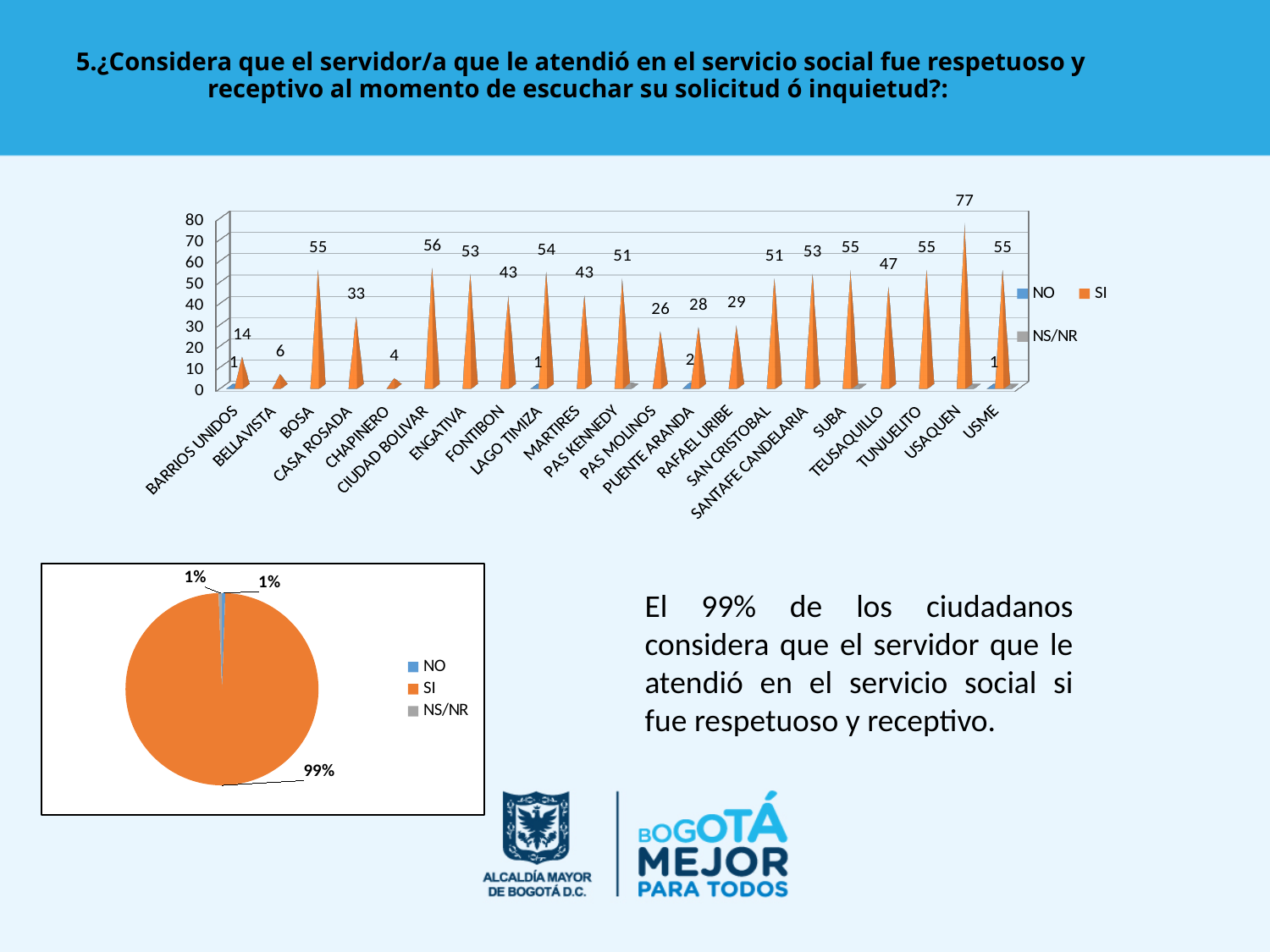
In the top bar chart, which has a larger SI value, CASA ROSADA or TEUSAQUILLO? TEUSAQUILLO In the top bar chart, what is the NO value for PUENTE ARANDA? 2 In the top bar chart, which category has the highest SI value? USAQUEN How many categories are shown on the x axis of the top bar chart? 21 In the pie chart at the bottom left, what share does SI have? 99% In the pie chart at the bottom left, what share does NO have? 1% In the top bar chart, which category has the lowest SI value? CHAPINERO In the top bar chart, what is the SI value for USAQUEN? 77 What kind of chart is the chart at the bottom left of the slide? Pie chart In the top bar chart, what is the difference between the SI values for USAQUEN and BOSA? 22 How many series does the legend of the top bar chart list? 3 What kind of chart is the top chart on the slide? Bar chart